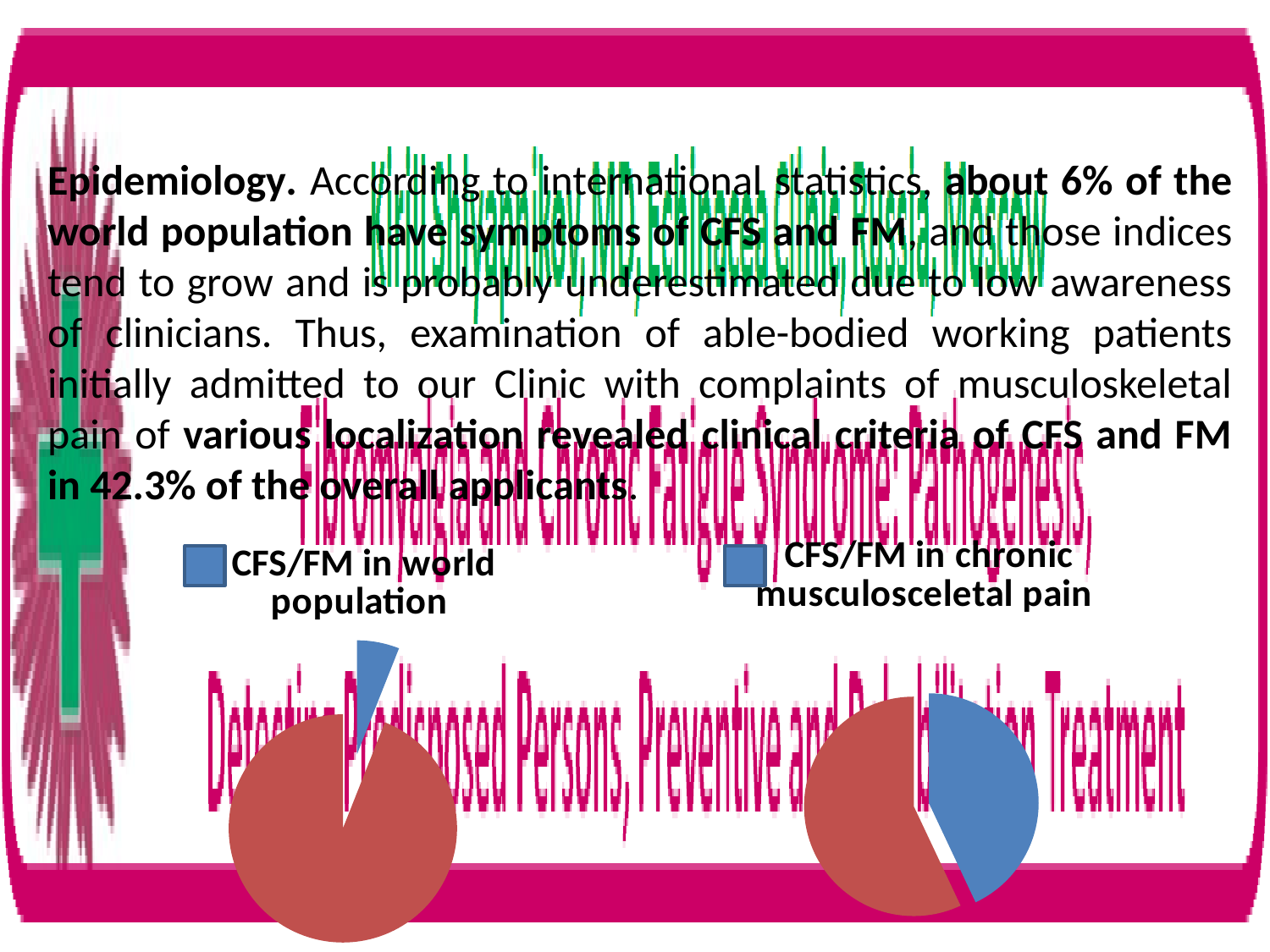
Which of the two pie charts has the larger blue slice, the left one or the right one? the right one In the chart titled "CFS/FM in chronic musculosceletal pain", how many slices does the pie have? 2 In the chart titled "CFS/FM in chronic musculosceletal pain", which slice is larger, the blue slice or the red slice? the red slice What kind of chart is the chart titled "CFS/FM in chronic musculosceletal pain"? pie chart In the chart titled "CFS/FM in world population", which slice is larger, the blue slice or the red slice? the red slice How many charts are shown on the slide? 2 In the chart titled "CFS/FM in world population", how many slices does the pie have? 2 What is the title of the pie chart on the right of the slide? CFS/FM in chronic musculosceletal pain In the chart titled "CFS/FM in chronic musculosceletal pain", which slice is the largest? the red slice What kind of chart is the chart titled "CFS/FM in world population"? pie chart What is the title of the pie chart on the left of the slide? CFS/FM in world population In the chart titled "CFS/FM in world population", which slice is the smallest? the blue slice